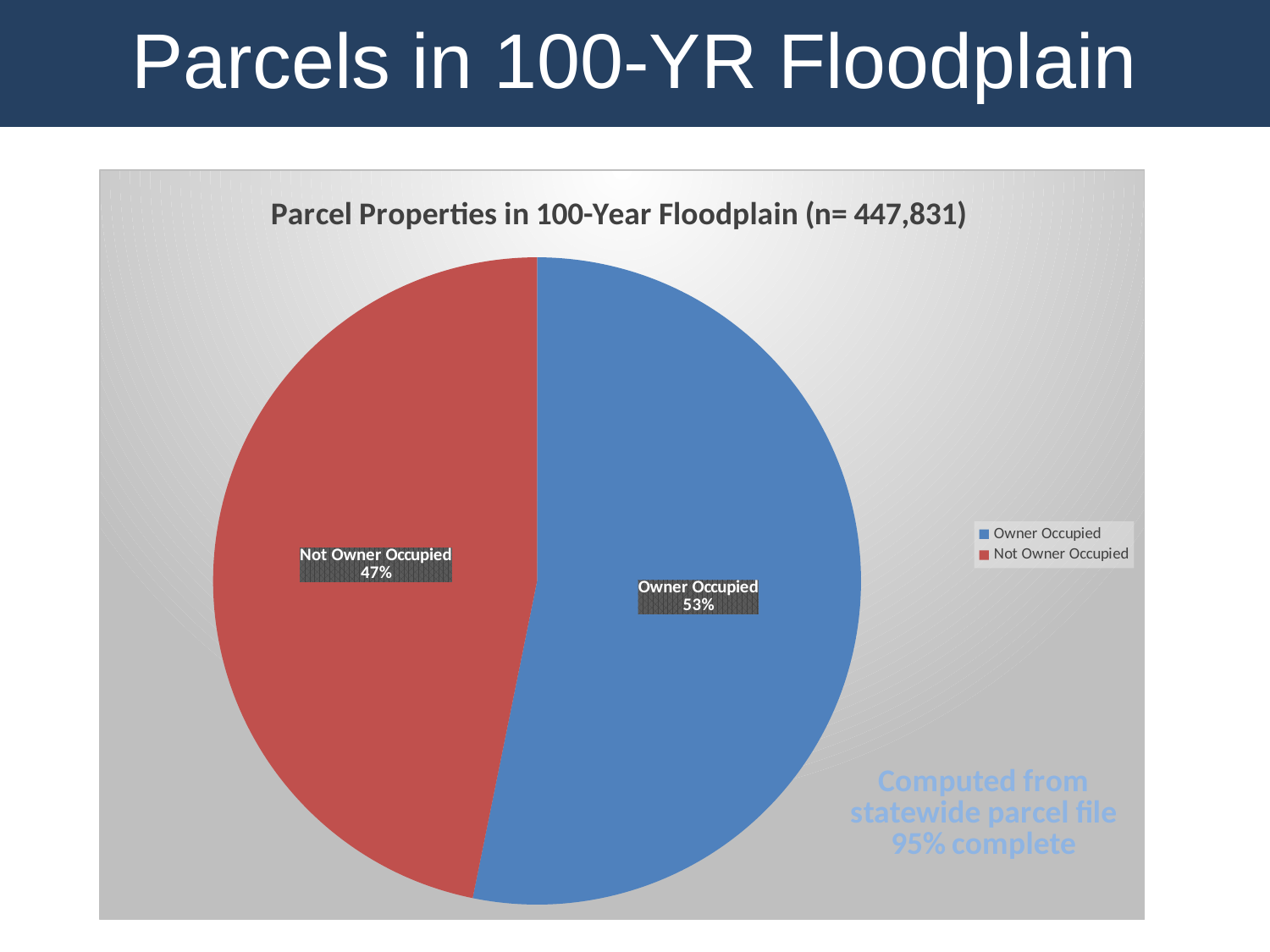
Which slice is larger, Owner Occupied or Not Owner Occupied? Owner Occupied Which category has the smallest slice of the pie? Not Owner Occupied What is the title of the chart? Parcel Properties in 100-Year Floodplain (n= 447,831) What colour is the Not Owner Occupied slice? Red What share of the pie is Owner Occupied? 53% What is the difference in percentage points between the Owner Occupied and Not Owner Occupied slices? 6 percentage points How many entries does the legend list? 2 What kind of chart is shown on the slide? Pie chart Which category has the largest slice of the pie? Owner Occupied What share of the pie is Not Owner Occupied? 47% How many slices does the pie chart have? 2 What is the total number of parcels (n) given in the chart title? 447,831